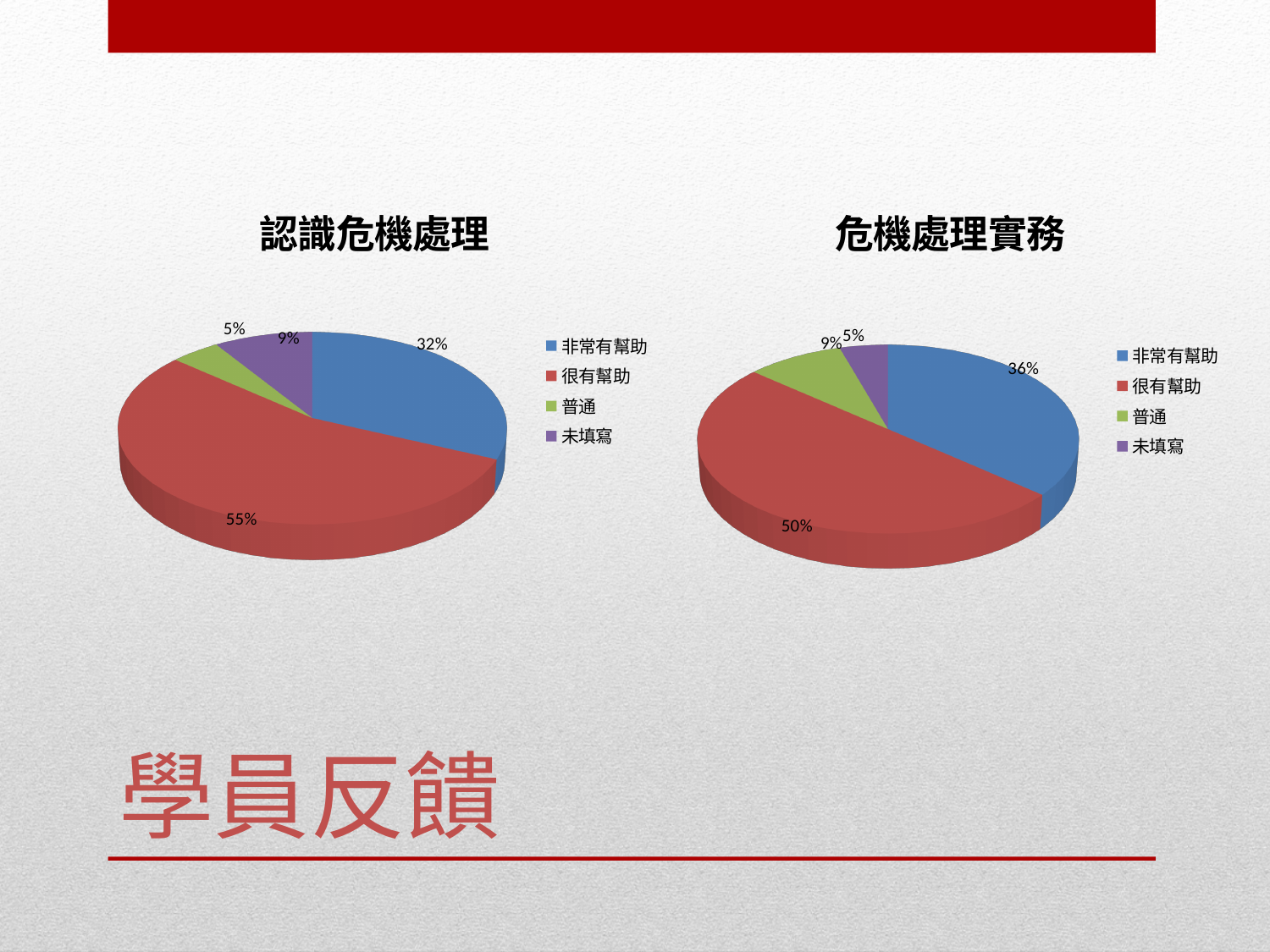
What type of chart is the 認識危機處理 chart? Pie chart In the 認識危機處理 chart, what colour represents 普通? Green In the 危機處理實務 chart, what percentage is 普通? 9% In the 危機處理實務 chart, what percentage is 非常有幫助? 36% In the 認識危機處理 chart, which category has the smallest share? 普通 Which is larger: 未填寫 in the 認識危機處理 chart or 未填寫 in the 危機處理實務 chart? 認識危機處理 In the 認識危機處理 chart, which category has the largest share? 很有幫助 How many categories does the legend of the 危機處理實務 chart list? 4 In the 認識危機處理 chart, what percentage is 非常有幫助? 32% In the 認識危機處理 chart, what percentage is 很有幫助? 55% In the 危機處理實務 chart, which category has the smallest share? 未填寫 In the 危機處理實務 chart, what is the difference between 很有幫助 and 非常有幫助? 14%